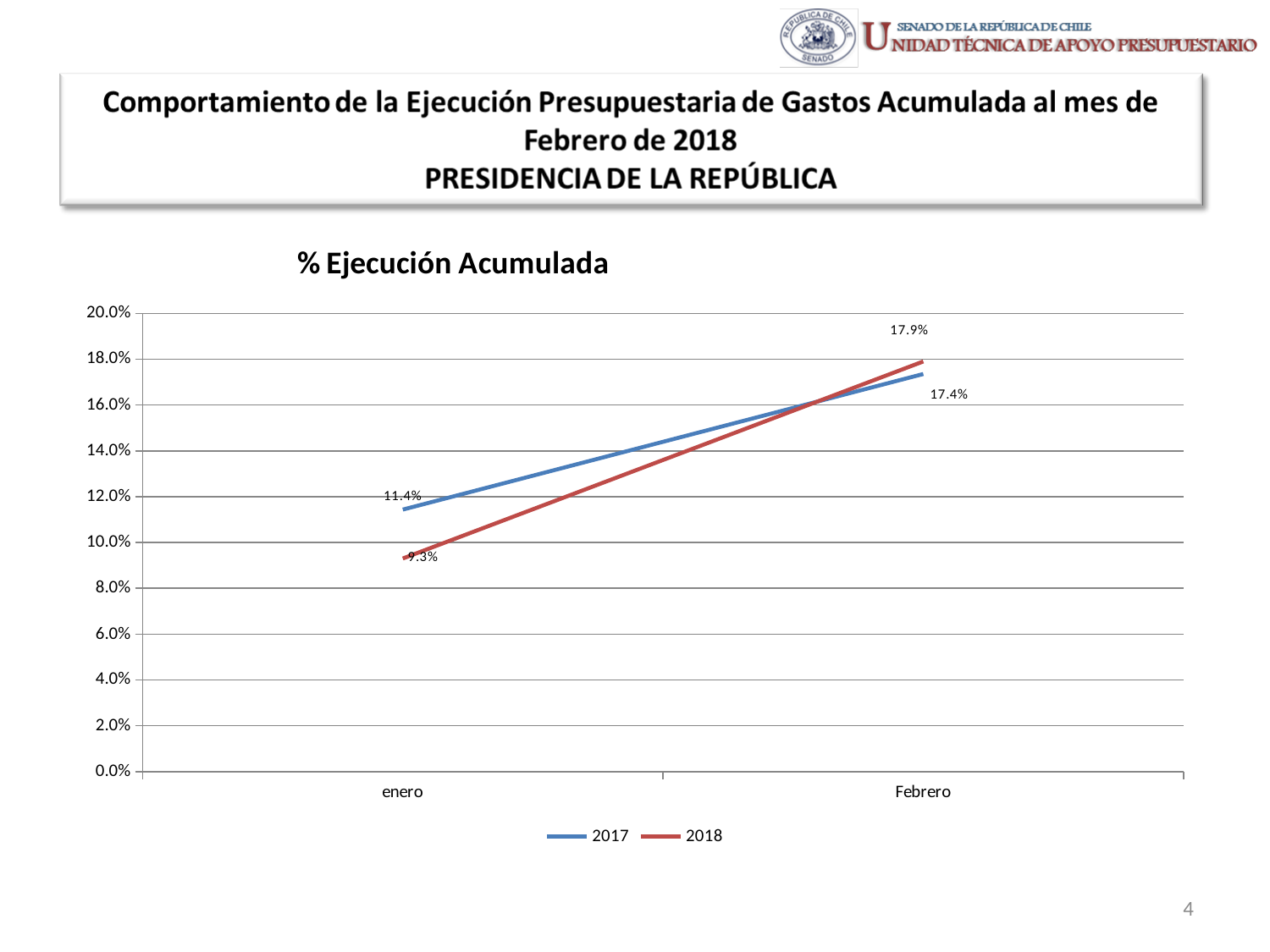
What is the difference between the 2018 values in Febrero and enero? 8.6% What is the value for 2018 in Febrero? 17.9% What is the value for 2018 in enero? 9.3% What is the value for 2017 in Febrero? 17.4% How many series does the legend list? 2 What is the title of the chart? % Ejecución Acumulada Do the values for 2018 rise or fall from enero to Febrero? Rise Which series has the higher value in Febrero, 2017 or 2018? 2018 What is the difference between the 2017 and 2018 values in enero? 2.1% Which series has the higher value in enero, 2017 or 2018? 2017 What kind of chart is shown? Line chart What is the value for 2017 in enero? 11.4%